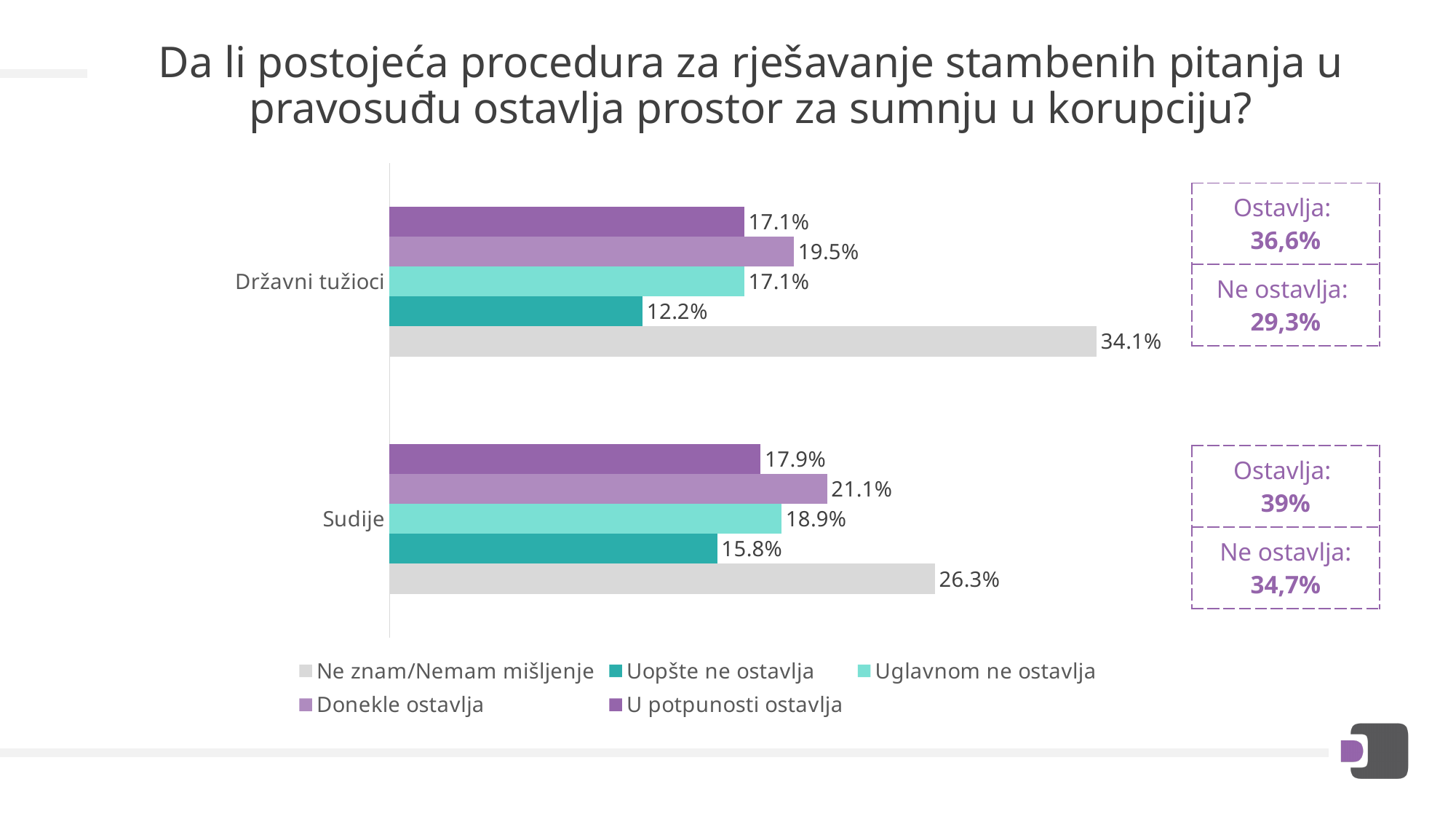
What total "Ostavlja" percentage is shown in the box next to the Sudije bars? 39% Which series has the lowest value for Državni tužioci? Uopšte ne ostavlja What is the value of "U potpunosti ostavlja" for Sudije? 17.9% What is the value of "Donekle ostavlja" for Sudije? 21.1% What is the value of "Uopšte ne ostavlja" for Državni tužioci? 12.2% What is the value of "Ne znam/Nemam mišljenje" for Državni tužioci? 34.1% How many series does the legend list? 5 What kind of chart is shown on the slide? Bar chart How many categories are shown on the chart? 2 Which series has the highest value for Sudije? Ne znam/Nemam mišljenje Which is larger: "Uglavnom ne ostavlja" for Sudije or for Državni tužioci? Sudije What is the difference between the "Ne znam/Nemam mišljenje" values for Državni tužioci and Sudije? 7.8%